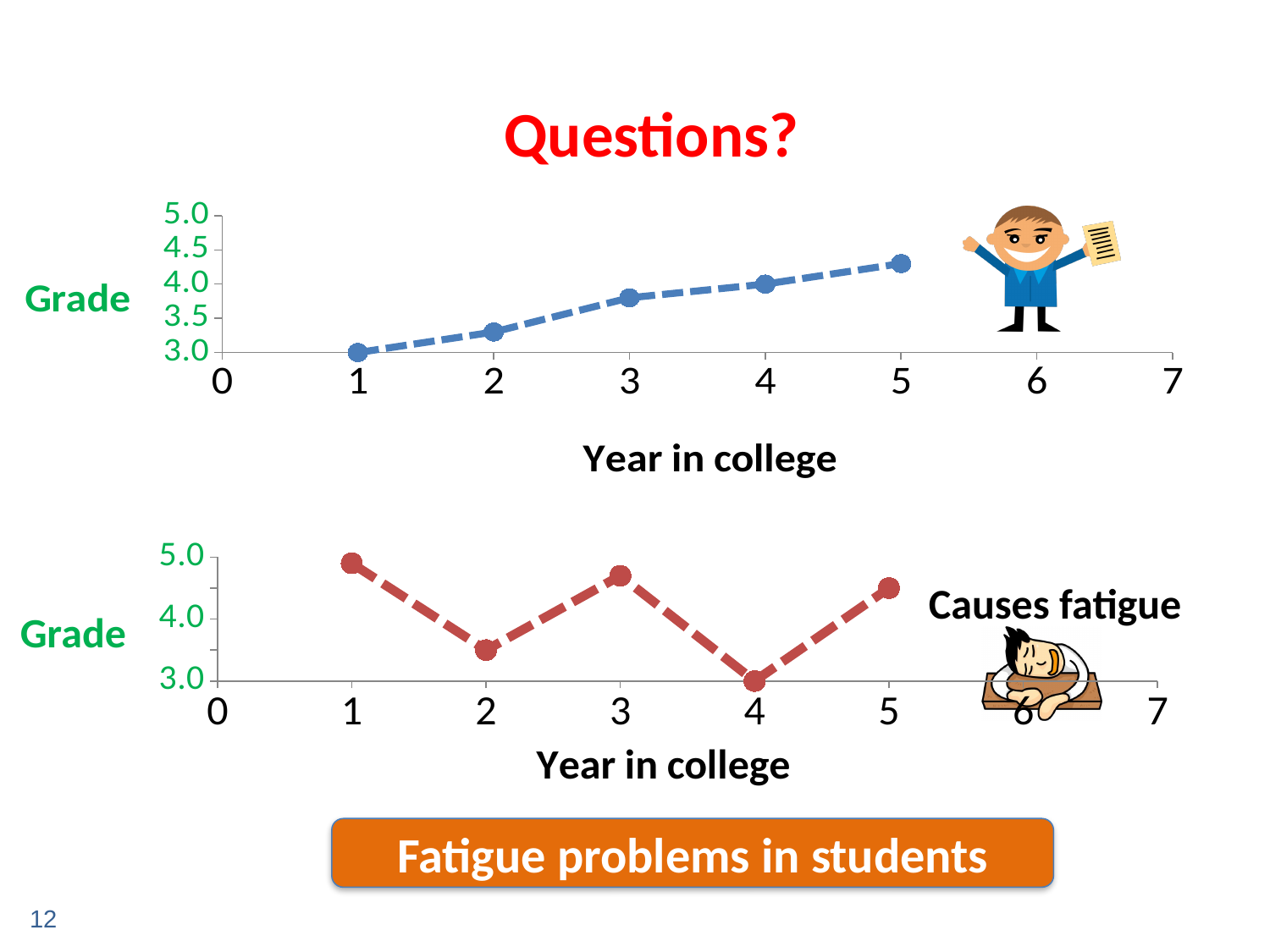
In the bottom chart, which year in college has the lowest grade? 4 In the bottom chart, what is the grade at year 4 in college? 3.0 In the bottom chart, is the grade at year 1 greater or less than 4.0? greater In the top chart, how many data points are plotted? 5 In the top chart, do grades rise or fall as the year in college increases? rise In the top chart, what is the grade at year 1 in college? 3.0 What kind of chart is the top chart on the slide? line chart In the bottom chart, how many data points are plotted? 5 In the top chart, what is the grade at year 4 in college? 4.0 In the bottom chart, which year has the larger grade, year 2 or year 3? 3 In the top chart, which year in college has the highest grade? 5 What kind of chart is the bottom chart on the slide? line chart